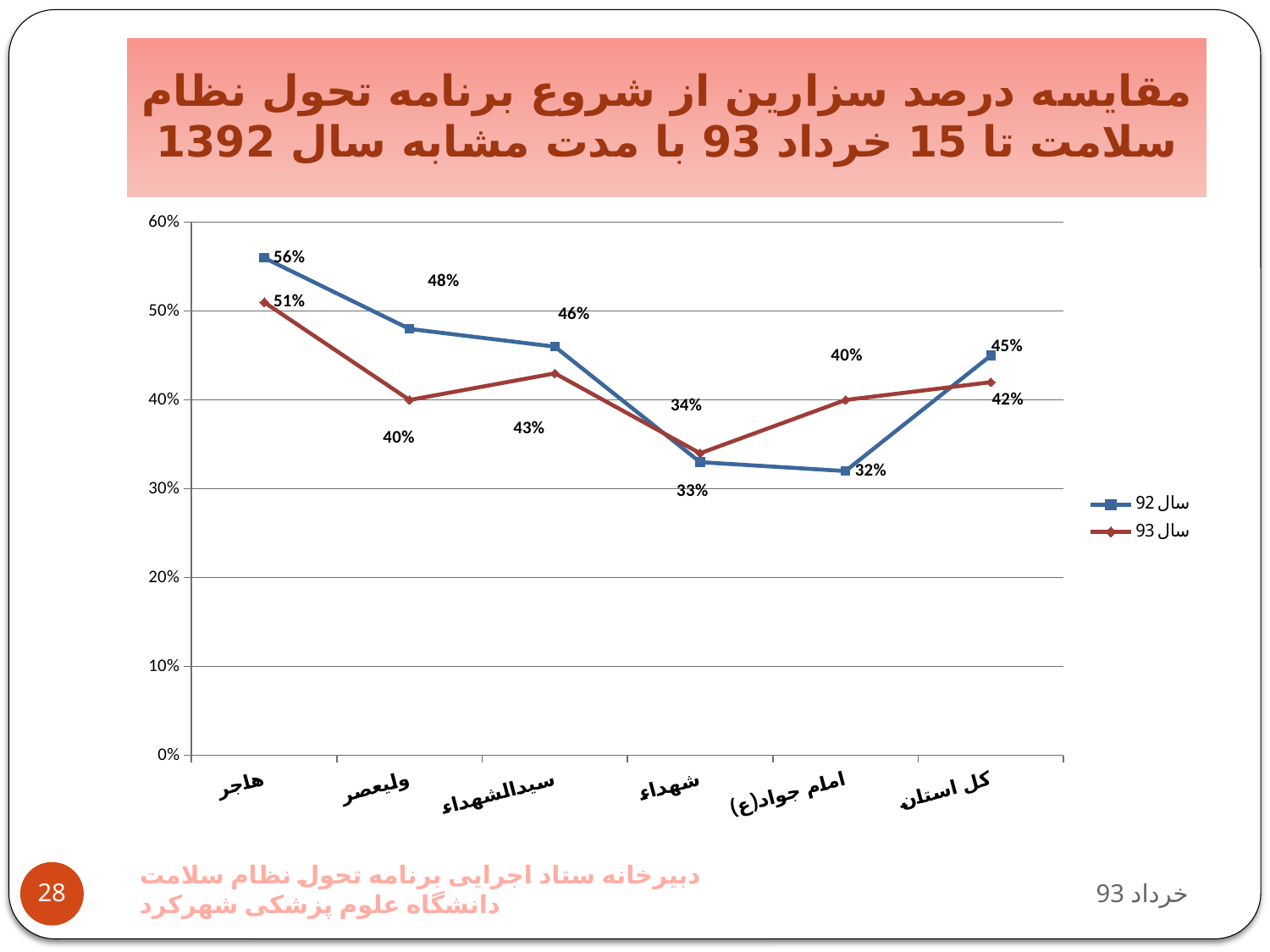
What is the value for کل استان in the سال 92 series? 45% How many series does the legend list? 2 What is the value for هاجر in the سال 92 series? 56% What is the difference between the سال 92 and سال 93 values for ولیعصر? 8% Which category has the highest value in the سال 92 series? هاجر How many categories are shown on the x axis? 6 What is the value for ولیعصر in the سال 93 series? 40% Which series is drawn in blue? سال 92 What type of chart is shown on the slide? line chart What is the value for امام جواد(ع) in the سال 93 series? 40% For امام جواد(ع), which series has the larger value, سال 92 or سال 93? سال 93 Which category has the lowest value in the سال 93 series? شهداء